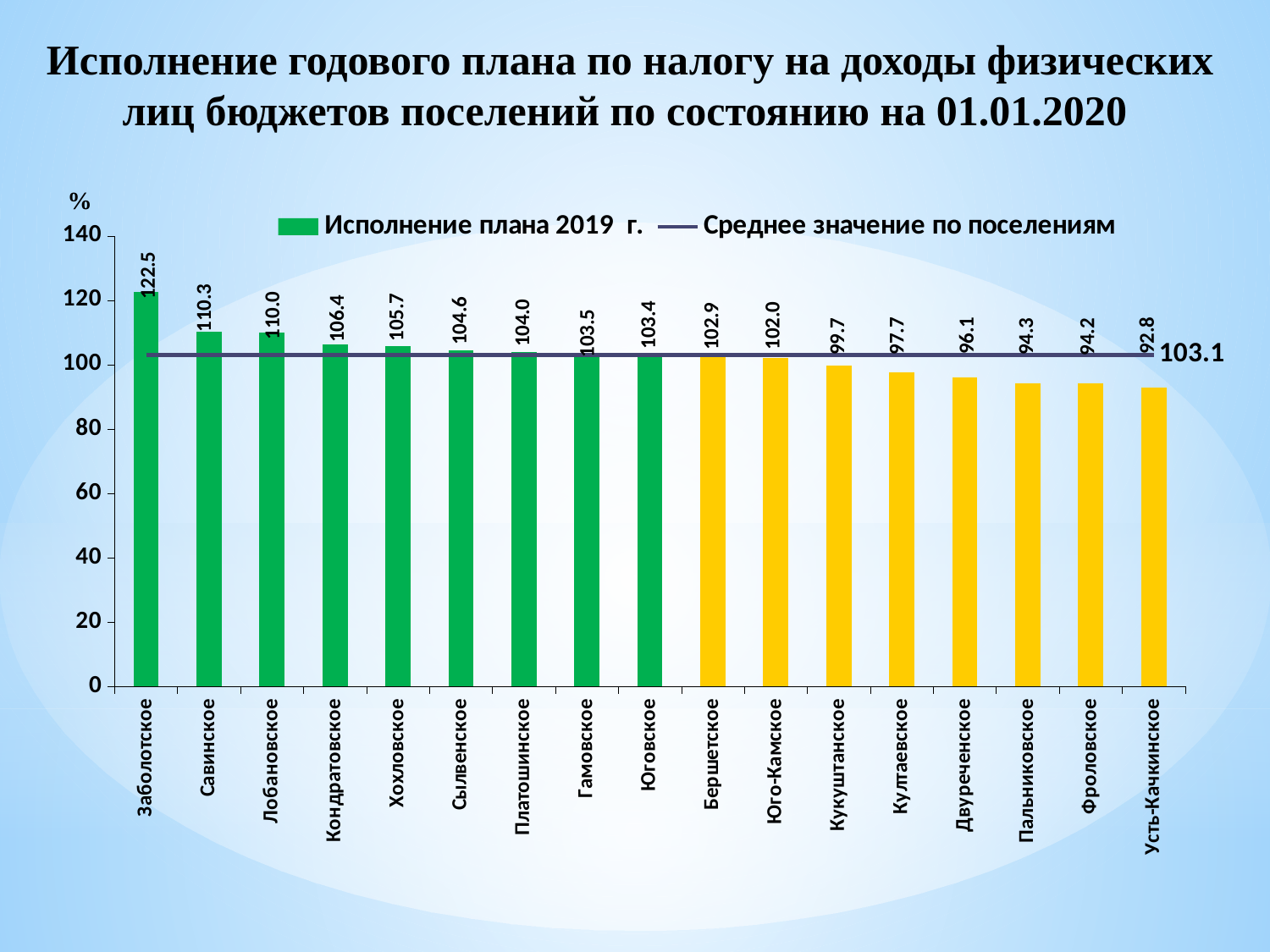
What is the difference between the values for Заболотское and Савинское? 12.2 How many settlements are shown on the x axis? 17 Which settlement has the highest plan execution value? Заболотское Which settlement has the lowest plan execution value? Усть-Качкинское What is the value for Кукуштанское? 99.7 What kind of chart is shown on the slide? combination bar and line chart What is the value for Усть-Качкинское? 92.8 What is the value for Заболотское? 122.5 Which is larger, the value for Кондратовское or the value for Двуреченское? Кондратовское Is the value for Култаевское greater or less than 100? less How many entries does the legend list? 2 What is the average value across settlements shown by the line (Среднее значение по поселениям)? 103.1